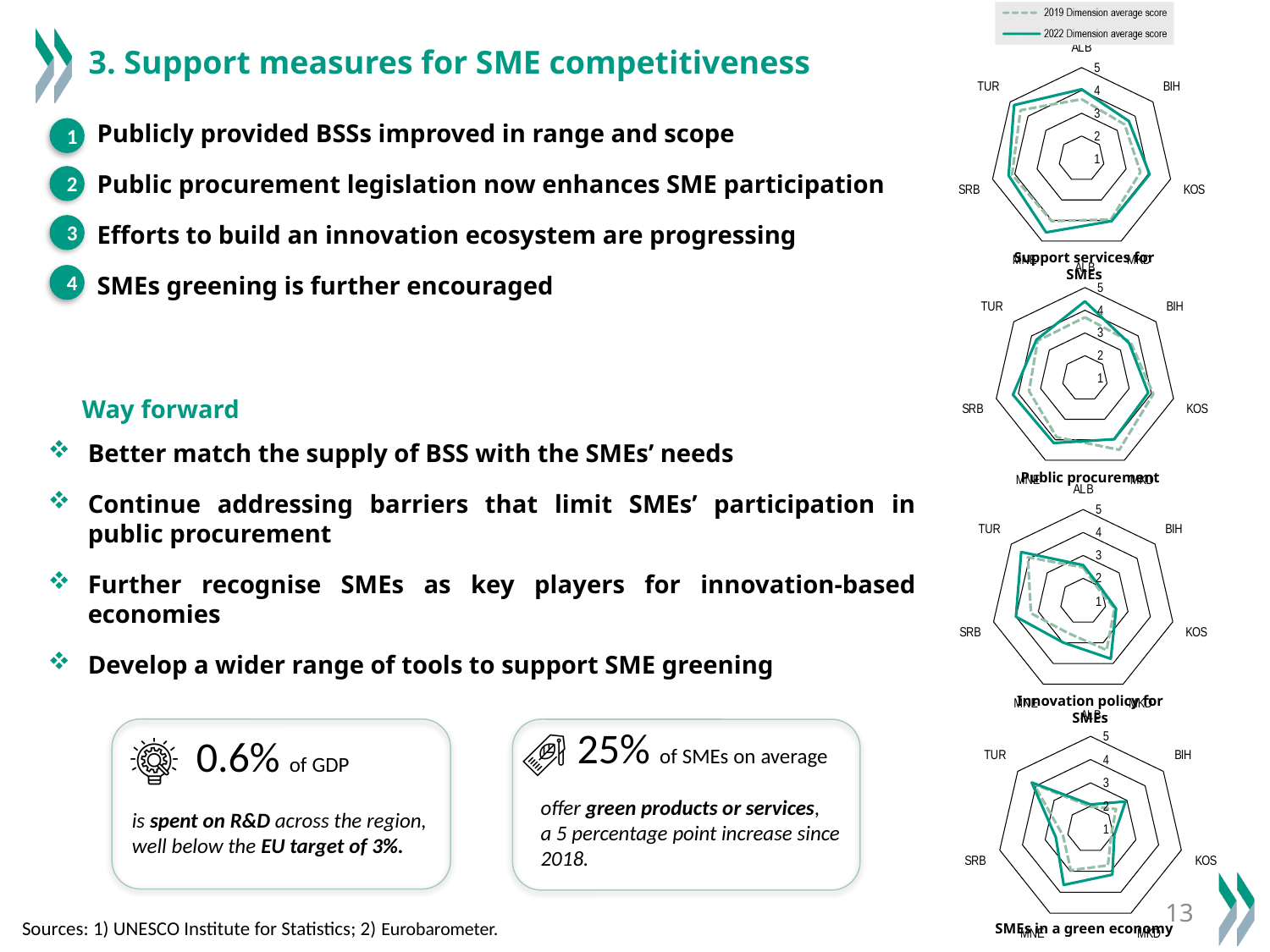
In the "Innovation policy for SMEs" chart, is the 2022 Dimension average score for KOS greater or less than 3? less How many economies (axes) are plotted on the "Public procurement" radar chart? 7 How many series does the legend at the top of the radar charts list? 2 In the "Support services for SMEs" chart, is the 2022 Dimension average score for TUR greater or less than 3? greater In the "Innovation policy for SMEs" chart, is the 2022 Dimension average score for BIH greater or less than 3? less How many radar charts are shown on the slide? 4 What is the highest value shown on the scale of the "Innovation policy for SMEs" radar chart? 5 What kind of chart is the "Support services for SMEs" chart? Radar chart